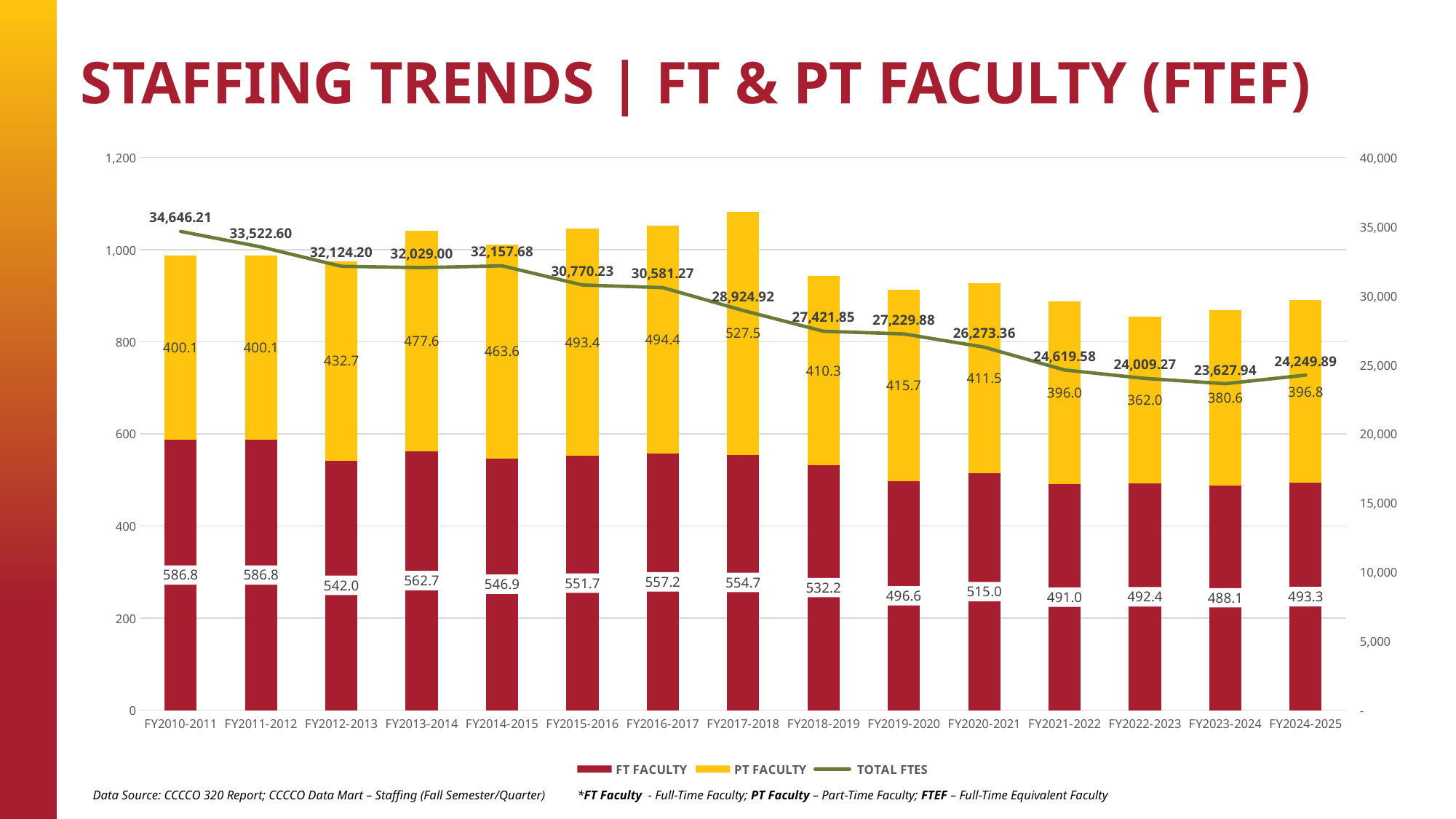
What is the Total FTES value for FY2024-2025? 24,249.89 What is the difference between the FT Faculty value in FY2010-2011 and in FY2024-2025? 93.5 How many series does the legend list? 3 Does the Total FTES line generally rise or fall from FY2010-2011 to FY2023-2024? Fall What is the FT Faculty value for FY2017-2018? 554.7 What is the PT Faculty value for FY2022-2023? 362.0 What kind of chart is used for the FT Faculty and PT Faculty series? Stacked bar chart What is the combined FT Faculty and PT Faculty total for the FY2017-2018 bar? 1082.2 Which is larger, the PT Faculty value in FY2013-2014 or in FY2014-2015? FY2013-2014 How many fiscal years are shown on the x axis? 15 In which fiscal year is the PT Faculty value highest? FY2017-2018 In which fiscal year is the Total FTES value lowest? FY2023-2024